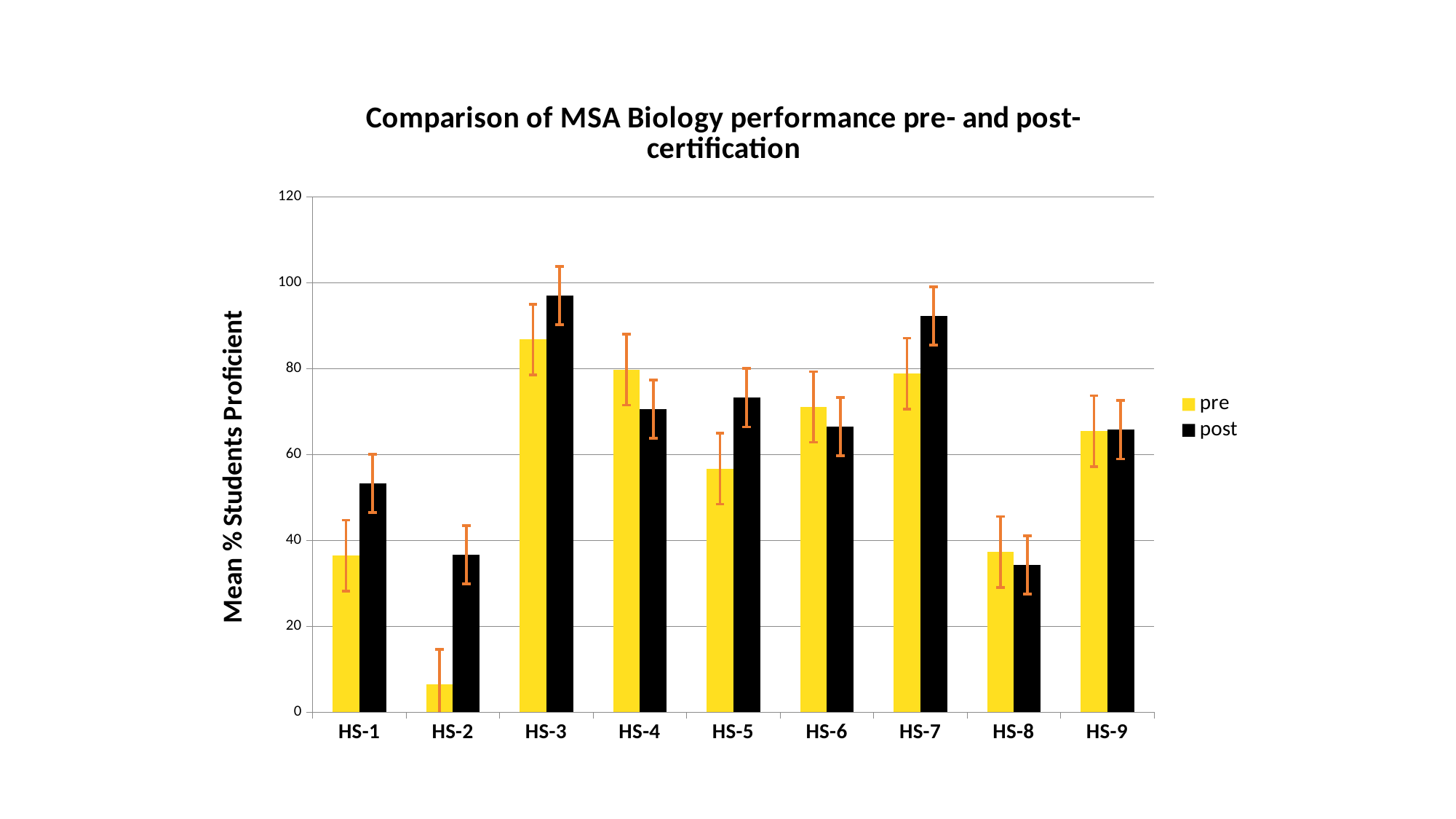
Is the pre value for HS-2 greater or less than 20? less For HS-4, which is larger, the pre or the post value? pre How many series does the legend list? 2 How many schools (categories) are shown on the x axis? 9 Is the post value for HS-5 greater or less than 60? greater What kind of chart is shown on the slide? bar chart Which school has the highest pre-certification value? HS-3 For HS-1, which is larger, the pre or the post value? post Is the post value for HS-3 greater or less than 80? greater What is the label of the y axis? Mean % Students Proficient Which school has the highest post-certification value? HS-3 Which school has the lowest pre-certification value? HS-2